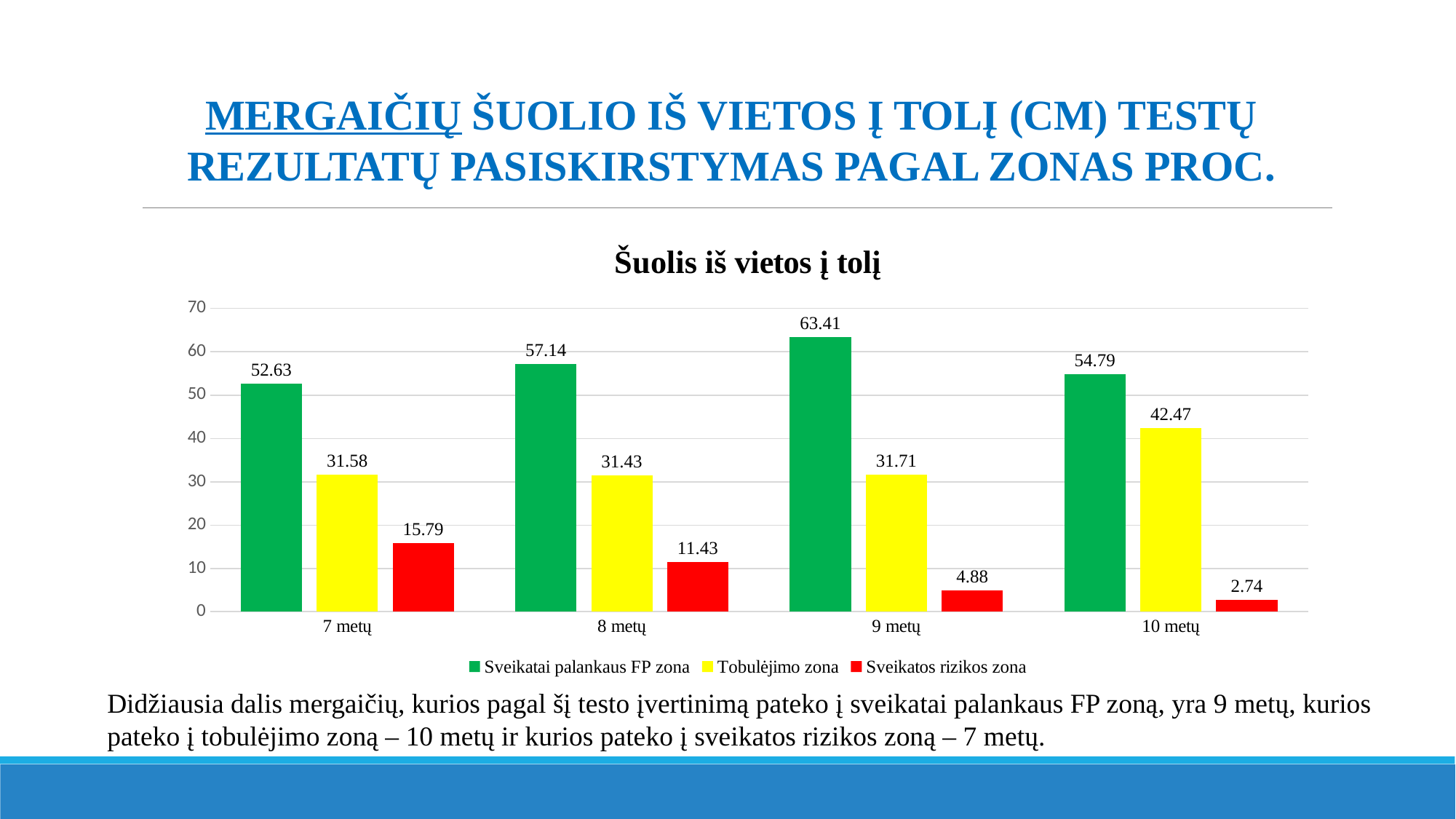
What is the value for Tobulėjimo zona for 10 metų? 42.47 Which age group has the highest value for Sveikatai palankaus FP zona? 9 metų Which is larger: the Tobulėjimo zona value for 10 metų or for 8 metų? 10 metų Which age group has the lowest value for Sveikatos rizikos zona? 10 metų What is the difference between the Sveikatai palankaus FP zona values for 9 metų and 7 metų? 10.78 Do the Sveikatos rizikos zona values rise or fall from 7 metų to 10 metų? fall How many age groups are shown on the x axis? 4 How many series does the legend list? 3 What is the value for Sveikatos rizikos zona for 7 metų? 15.79 Is the value for Sveikatai palankaus FP zona for 8 metų greater or less than 50? greater What is the value for Sveikatai palankaus FP zona for 9 metų? 63.41 What kind of chart is shown on the slide? bar chart